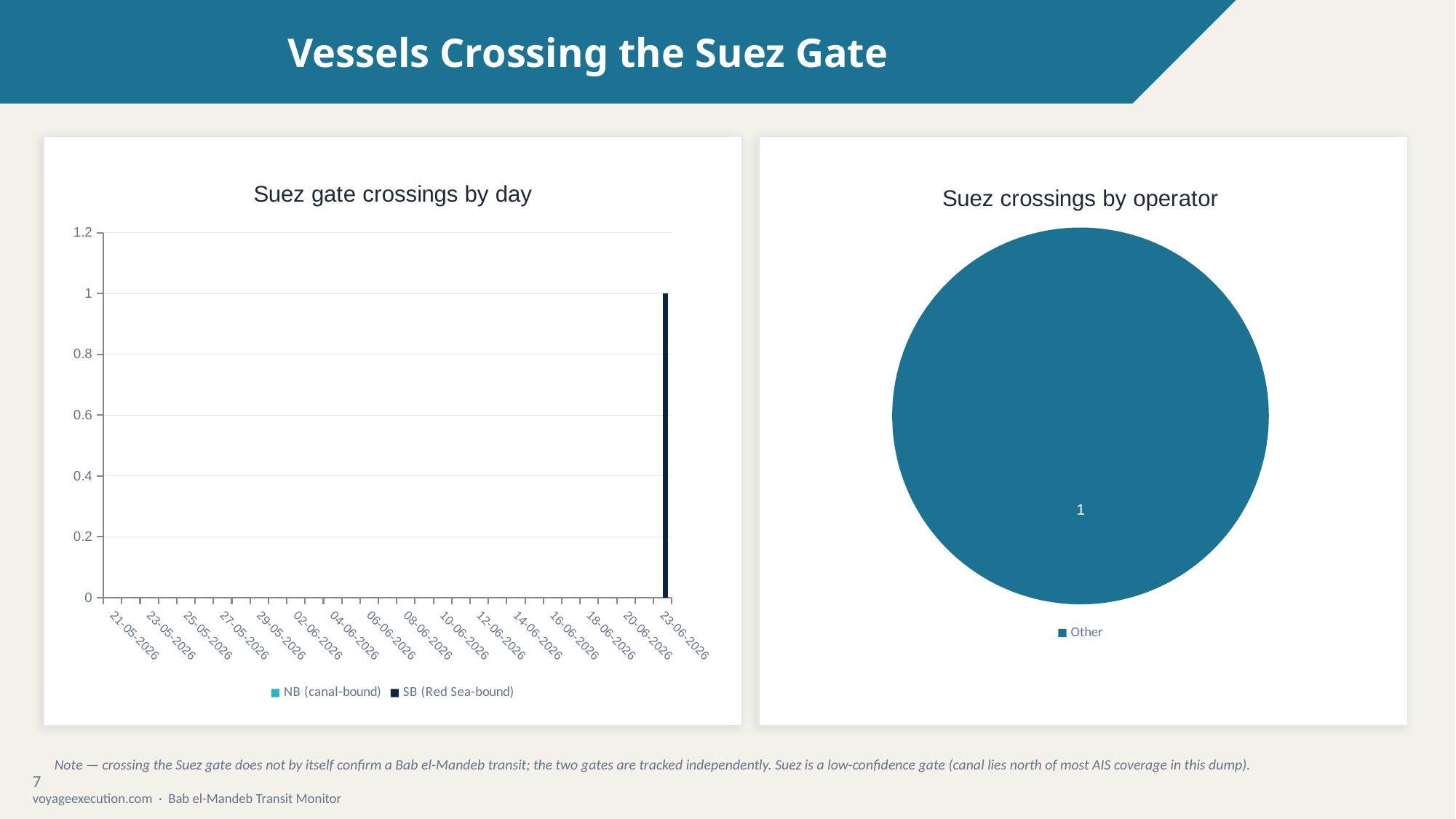
In 'Suez crossings by operator', what share of the pie does Other represent? 100% In 'Suez gate crossings by day', which series does the bar on 23-06-2026 belong to? SB (Red Sea-bound) In 'Suez crossings by operator', how many entries does the legend list? 1 In 'Suez gate crossings by day', what is the value of the bar on 23-06-2026? 1 In 'Suez gate crossings by day', how many series does the legend list? 2 What kind of chart is 'Suez gate crossings by day'? bar chart In 'Suez gate crossings by day', what are the two series named in the legend? NB (canal-bound) and SB (Red Sea-bound) What kind of chart is 'Suez crossings by operator'? pie chart In 'Suez gate crossings by day', on which date is the only visible bar? 23-06-2026 In 'Suez crossings by operator', how many slices does the pie have? 1 In 'Suez gate crossings by day', is the value for 23-06-2026 greater or less than 0.6? greater In 'Suez crossings by operator', what value is shown for Other? 1